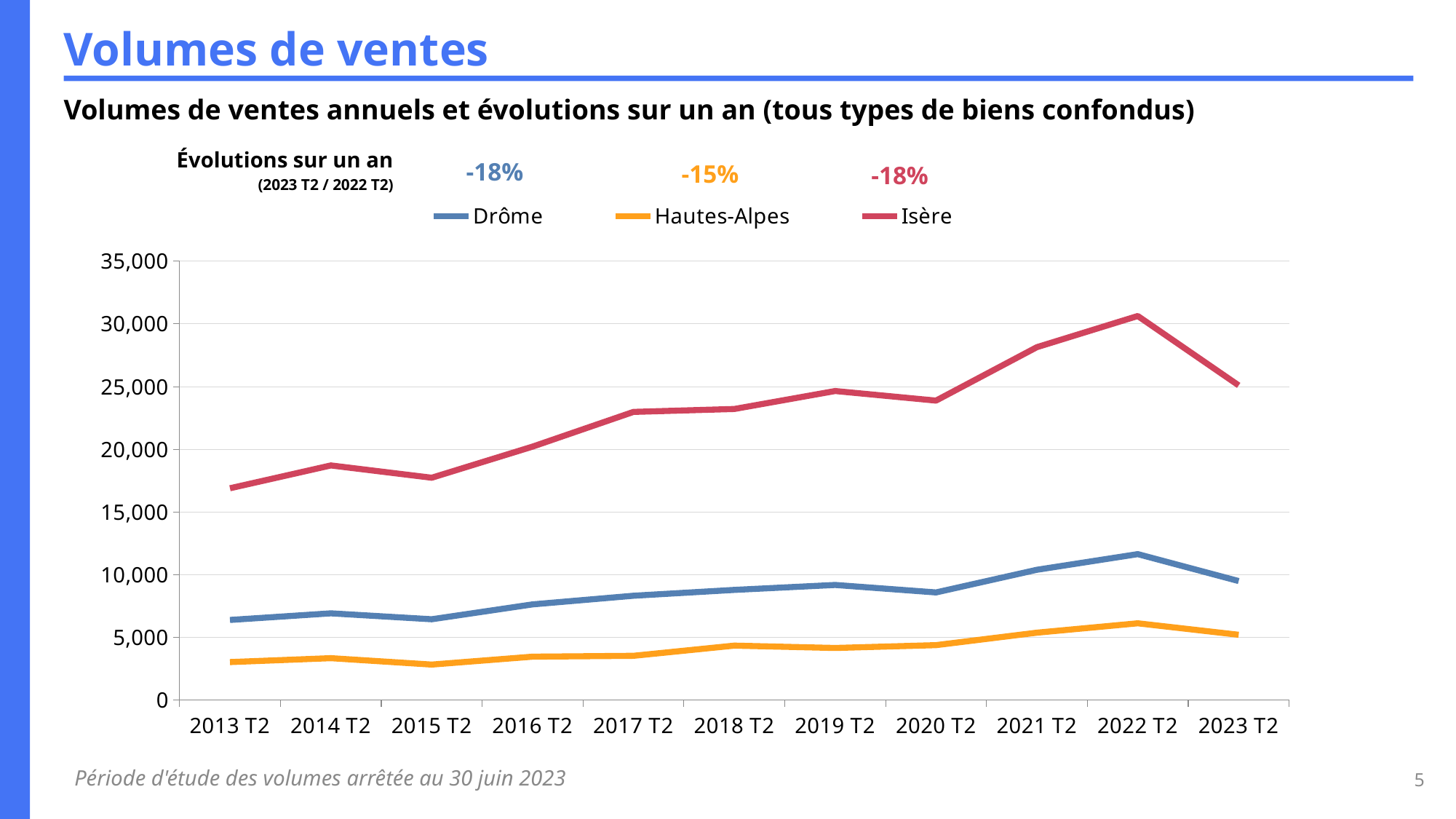
What colour is the line for Isère? red How many series does the legend list? 3 In which period does the Isère line reach its highest value? 2022 T2 How many time points are shown on the x axis? 11 Is the value for Drôme in 2022 T2 greater or less than 10,000? greater Is the value for Isère in 2017 T2 greater or less than 20,000? greater Is the value for Hautes-Alpes in 2015 T2 greater or less than 5,000? less In which period does the Isère line have its lowest value? 2013 T2 Which series has the highest values across the whole period? Isère Do the values for all three series rise or fall between 2022 T2 and 2023 T2? fall What is the one-year evolution (2023 T2 / 2022 T2) shown for Hautes-Alpes? -15% What kind of chart is shown on the slide? line chart